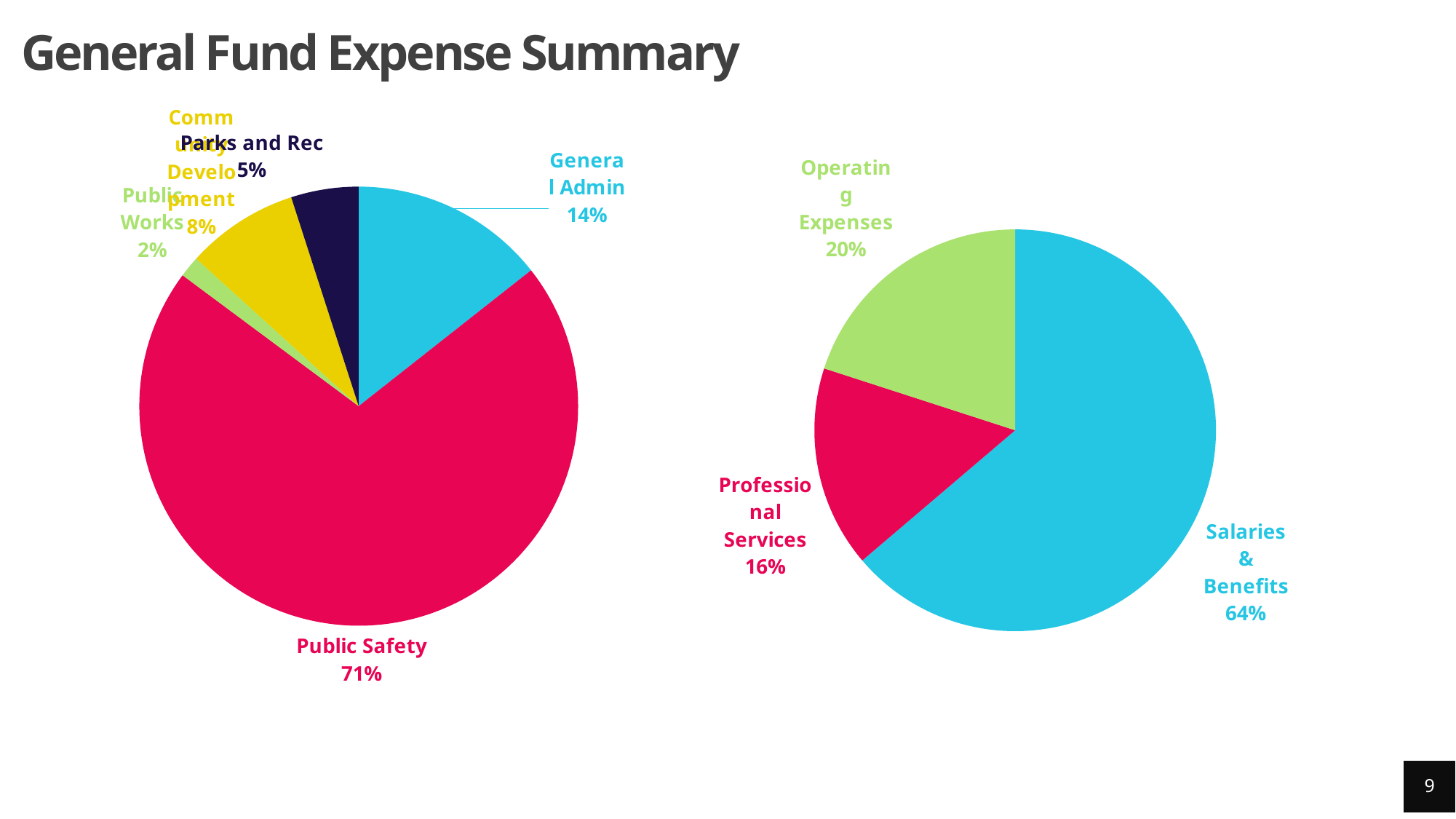
In the left pie chart, what share does Public Safety have? 71% In the left pie chart, which category has the largest share? Public Safety In the left pie chart, what is the difference in percentage points between General Admin and Community Development? 6 In the left pie chart, how many slices are there? 5 In the left pie chart, what percentage is shown for General Admin? 14% In the right pie chart, which is larger: Operating Expenses or Professional Services? Operating Expenses In the left pie chart, what percentage is shown for Parks and Rec? 5% In the right pie chart, what share does Salaries & Benefits have? 64% What type of chart is shown on the right side of the slide? Pie chart In the right pie chart, what percentage is shown for Professional Services? 16% In the left pie chart, which category has the smallest share? Public Works In the right pie chart, how many slices are there? 3